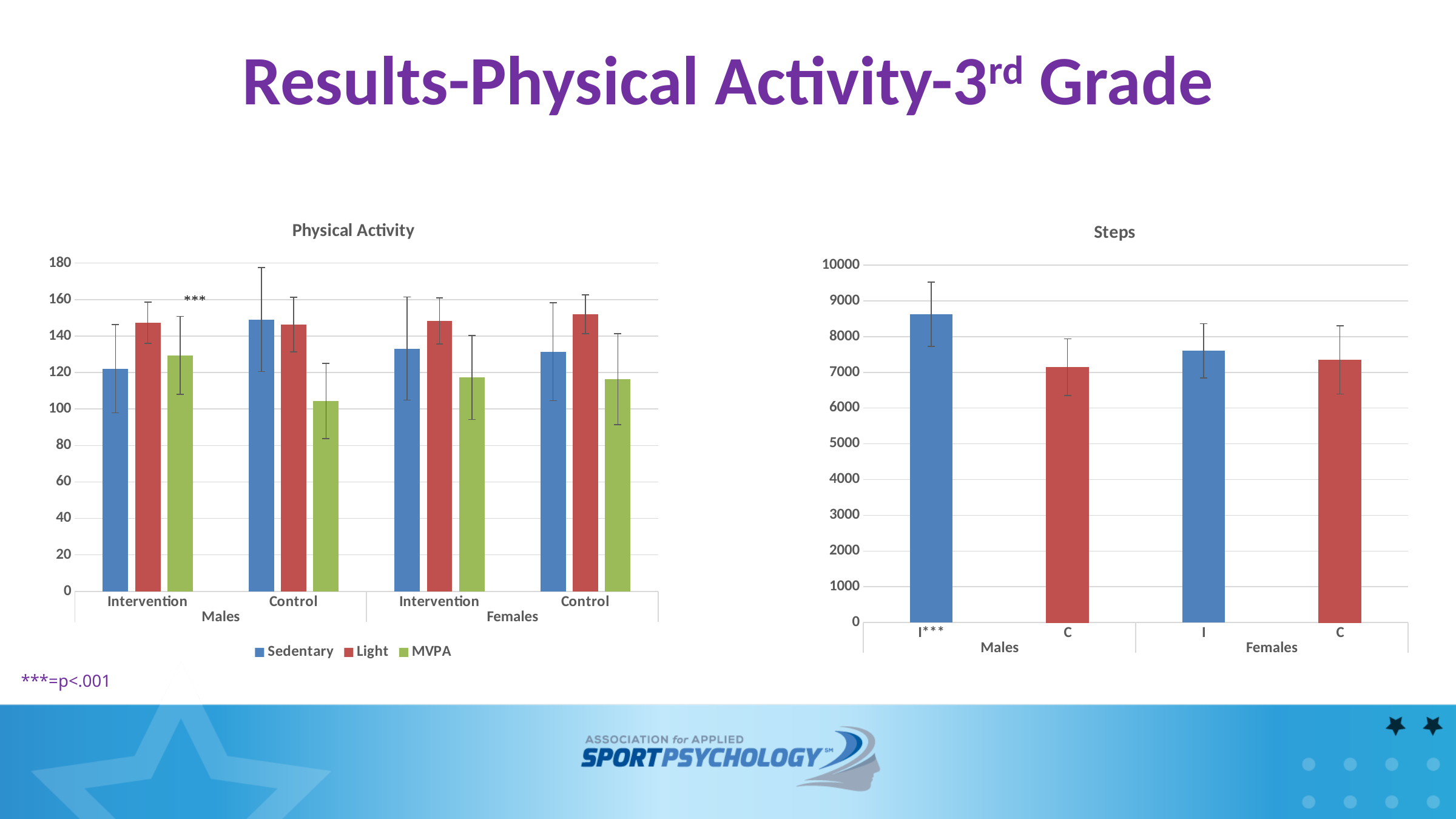
In the 'Steps' chart, is the value for Males I*** greater or less than 8000? greater In the 'Steps' chart, how many bars are plotted? 4 In the 'Steps' chart, which bar is the highest? Males I*** In the 'Physical Activity' chart, which group has the lowest MVPA bar? Males Control In the 'Physical Activity' chart, for Males Intervention, which is larger: Sedentary or Light? Light In the 'Physical Activity' chart, is the Sedentary value for Males Intervention greater or less than 140? less In the 'Steps' chart, which is larger: the Males I*** bar or the Females I bar? Males I*** In the 'Physical Activity' chart, what are the three series named in the legend? Sedentary, Light, MVPA In the 'Physical Activity' chart, how many series does the legend list? 3 In the 'Steps' chart, is the value for Males C greater or less than 8000? less What kind of chart is the 'Physical Activity' chart on the left? bar chart